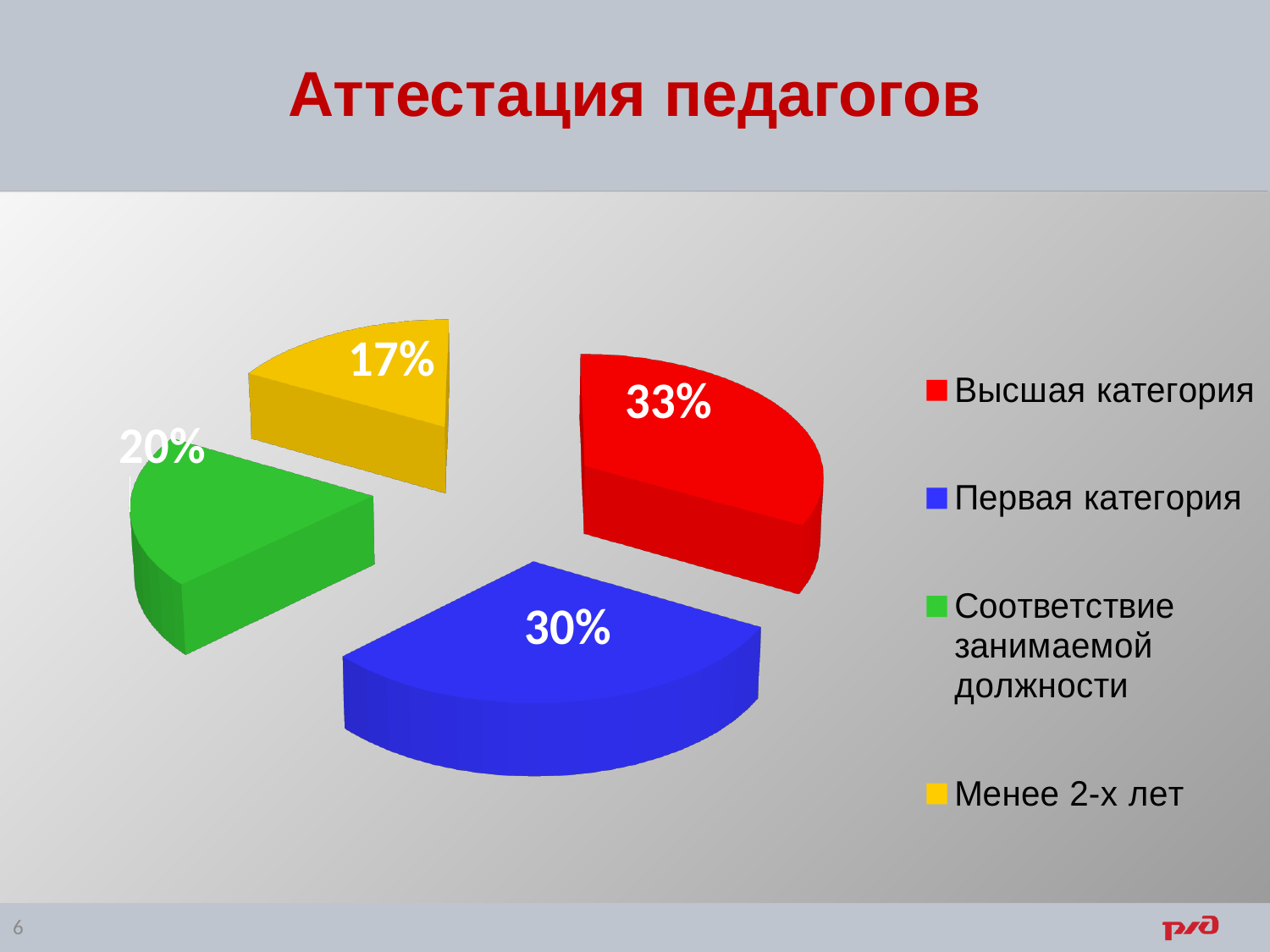
What is the difference in percentage points between Первая категория and Соответствие занимаемой должности? 10 Which category has the smallest slice of the pie? Менее 2-х лет What is the difference in percentage points between Высшая категория and Менее 2-х лет? 16 What share of the pie does Менее 2-х лет have? 17% What share of the pie does Соответствие занимаемой должности have? 20% What is the title of the slide containing the chart? Аттестация педагогов How many categories does the pie chart show? 4 What share of the pie does Высшая категория have? 33% Which category has the largest slice of the pie? Высшая категория Which is larger, Высшая категория or Первая категория? Высшая категория What kind of chart is shown on the slide? Pie chart